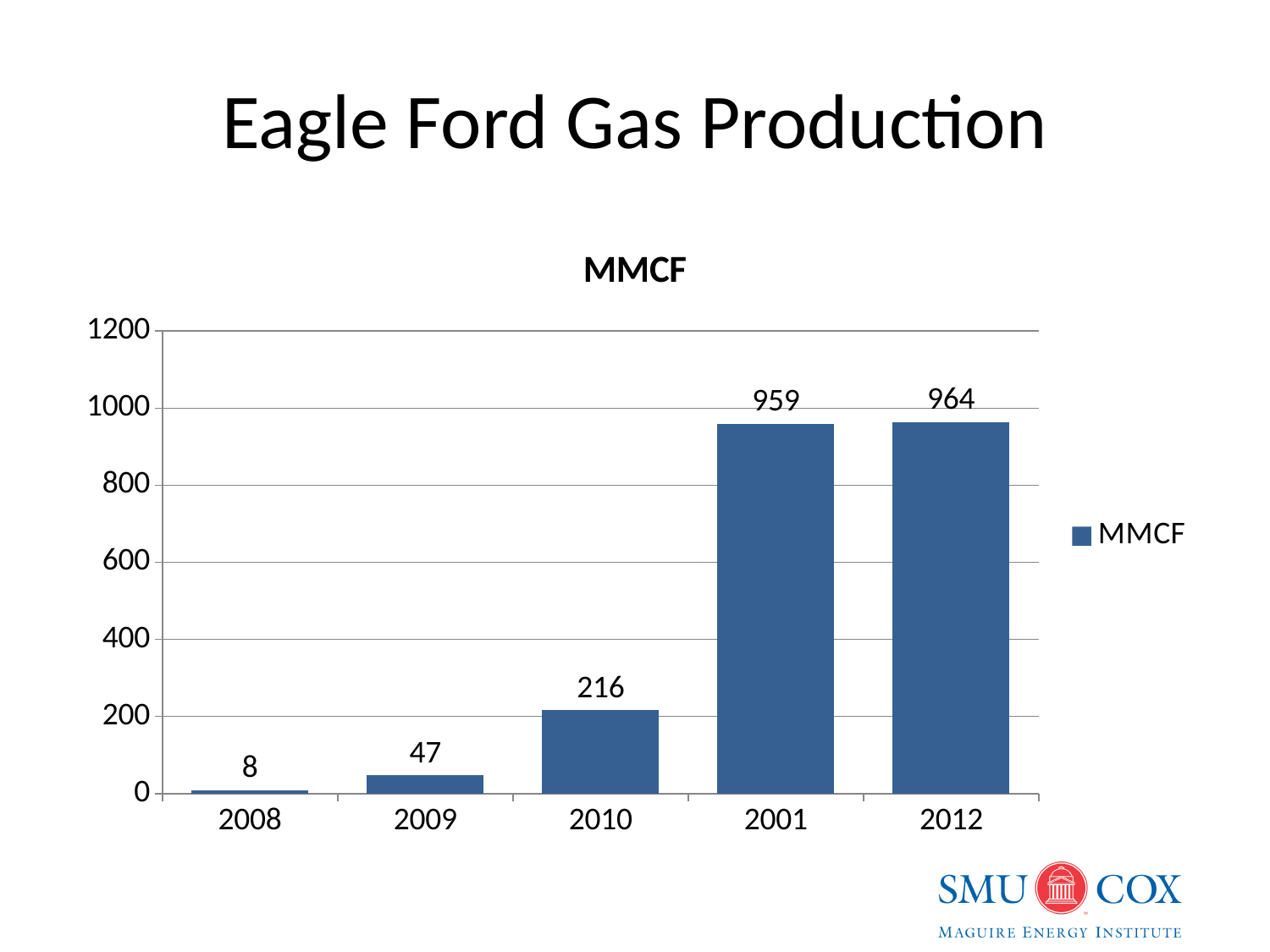
Which category has the lowest value? 2008 What is the value for 2009? 47 What is the value for 2008? 8 What is the chart's title? MMCF What is the difference between the values for 2012 and 2001? 5 What is the value for the category labelled 2001? 959 What is the difference between the values for 2010 and 2009? 169 Which is larger, the value for 2010 or the value for 2009? 2010 Which category has the highest value? 2012 What is the value for 2010? 216 What kind of chart is this? bar chart How many categories are shown on the x axis? 5